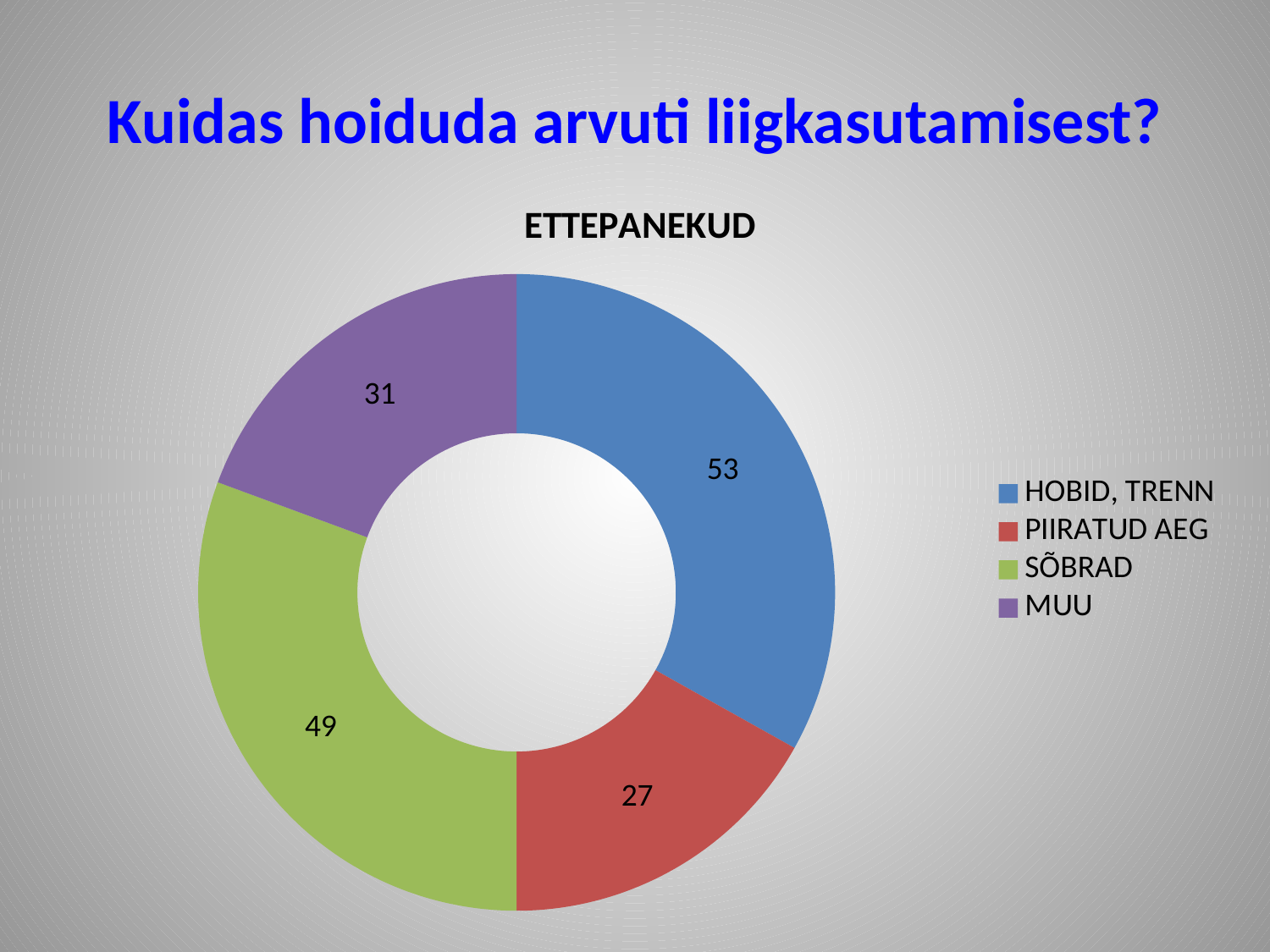
What is the difference between the values for HOBID, TRENN and PIIRATUD AEG? 26 What is the value for SÕBRAD in the ETTEPANEKUD chart? 49 Which is larger, the value for SÕBRAD or the value for MUU? SÕBRAD What is the value for HOBID, TRENN in the ETTEPANEKUD chart? 53 Which category has the highest value in the ETTEPANEKUD chart? HOBID, TRENN Which category has the lowest value in the ETTEPANEKUD chart? PIIRATUD AEG What kind of chart is shown on the slide? doughnut chart How many categories are shown in the ETTEPANEKUD chart? 4 What is the value for PIIRATUD AEG in the ETTEPANEKUD chart? 27 What colour represents MUU in the chart? purple What is the total of all values in the ETTEPANEKUD chart? 160 What is the value for MUU in the ETTEPANEKUD chart? 31